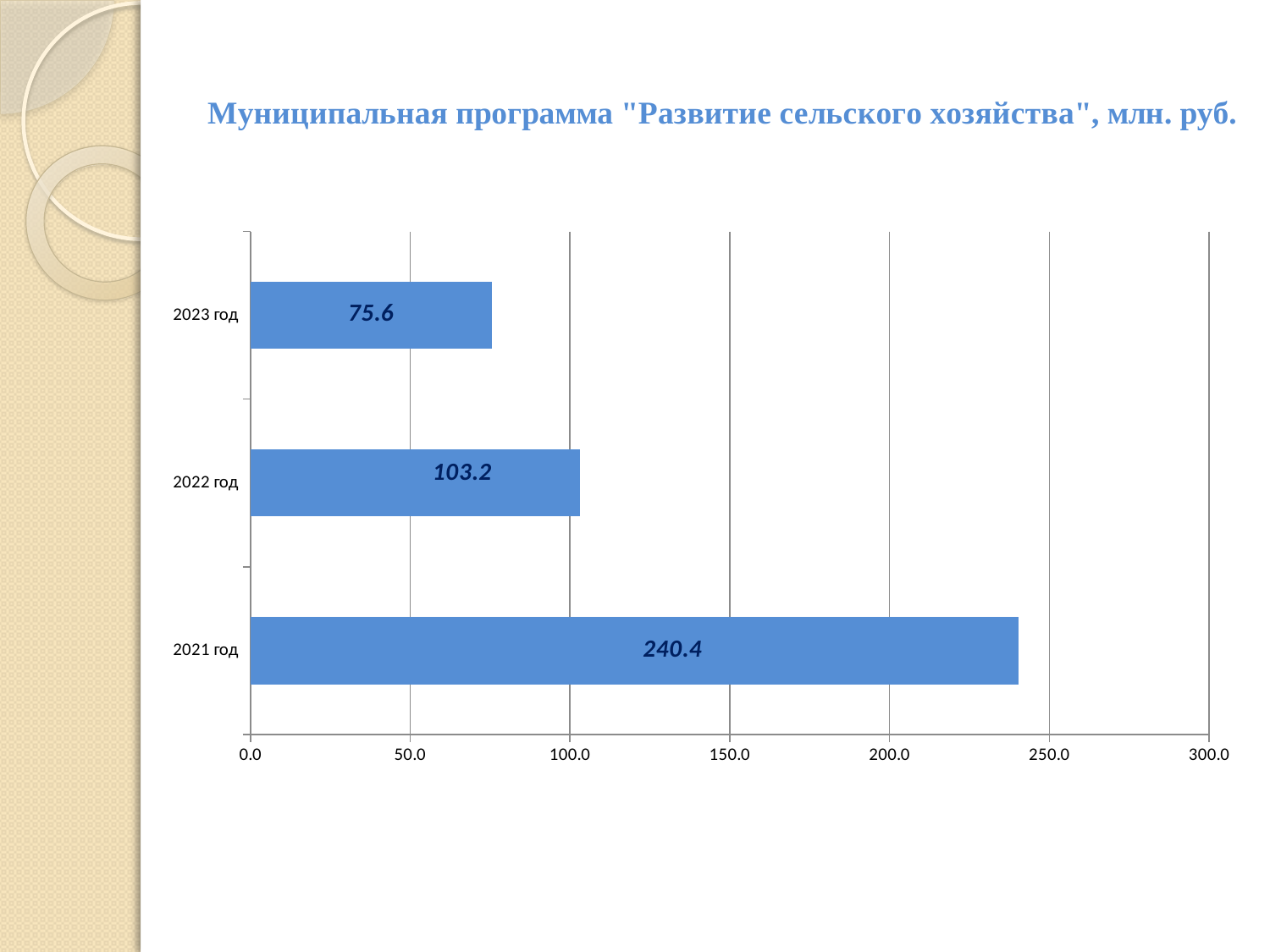
What is the value for 2021 год? 240.4 What is the value for 2022 год? 103.2 What kind of chart is shown on the slide? bar chart Which year has the lowest value? 2023 год Which year has the highest value? 2021 год How many years are shown in the chart? 3 What is the title of the chart? Муниципальная программа "Развитие сельского хозяйства", млн. руб. What is the difference between the values for 2021 год and 2022 год? 137.2 Is the value for 2021 год greater or less than 200.0? greater What is the difference between the values for 2022 год and 2023 год? 27.6 Which is larger, the value for 2022 год or the value for 2023 год? 2022 год What is the value for 2023 год? 75.6